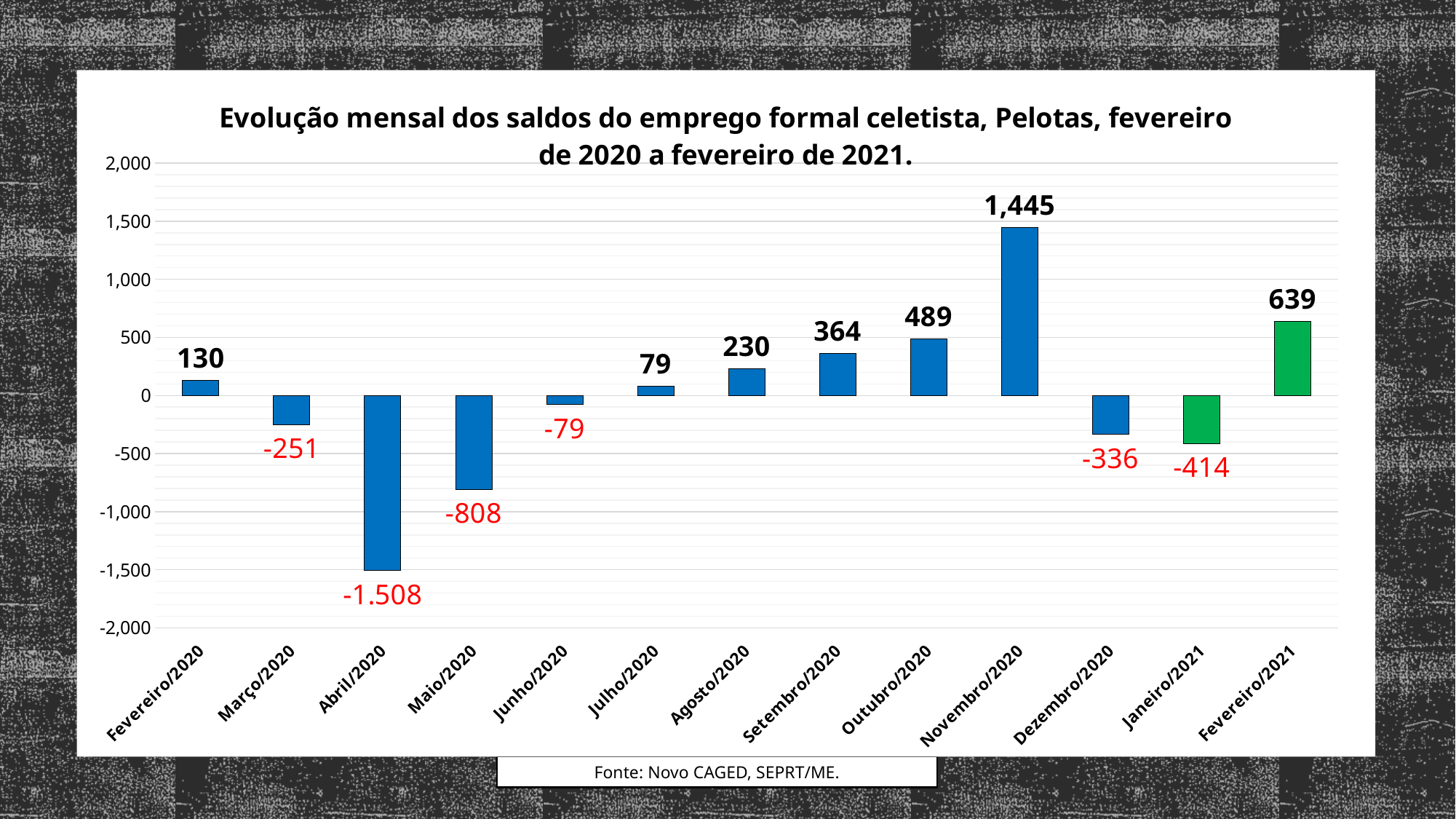
Which month has the highest value? Novembro/2020 What is the value for Fevereiro/2021? 639 What is the value for Novembro/2020? 1,445 What is the value for Maio/2020? -808 Which is larger, the value for Agosto/2020 or the value for Julho/2020? Agosto/2020 Which month has the lowest value? Abril/2020 What source is cited below the chart? Fonte: Novo CAGED, SEPRT/ME. How many months are shown on the x axis? 13 What is the value for Abril/2020? -1.508 What is the difference between the values for Outubro/2020 and Setembro/2020? 125 Is the value for Novembro/2020 greater or less than 1,000? greater What kind of chart is shown on the slide? bar chart